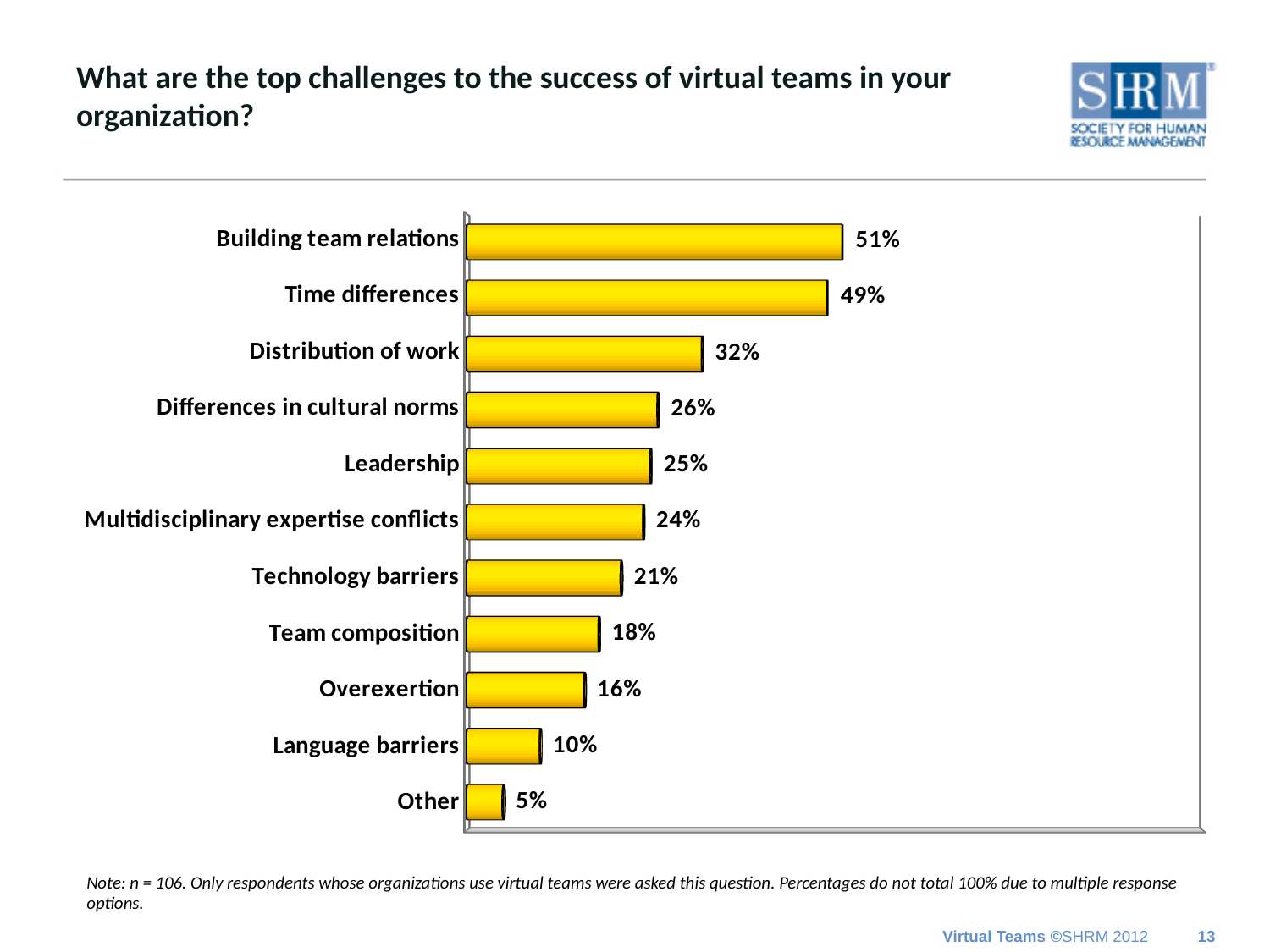
What is the difference between the values for Team composition and Overexertion? 2% How many categories are shown in the chart? 11 What is the difference between the values for Time differences and Distribution of work? 17% What kind of chart is shown on the slide? Bar chart What is the value shown for Technology barriers? 21% Which is larger, the value for Leadership or the value for Technology barriers? Leadership Which challenge has the highest percentage? Building team relations Do the values rise or fall going from the top bar to the bottom bar? Fall Which category has the lowest percentage? Other What colour are the bars in the chart? Yellow What percentage of respondents cited Building team relations as a top challenge? 51% What is the value shown for Language barriers? 10%